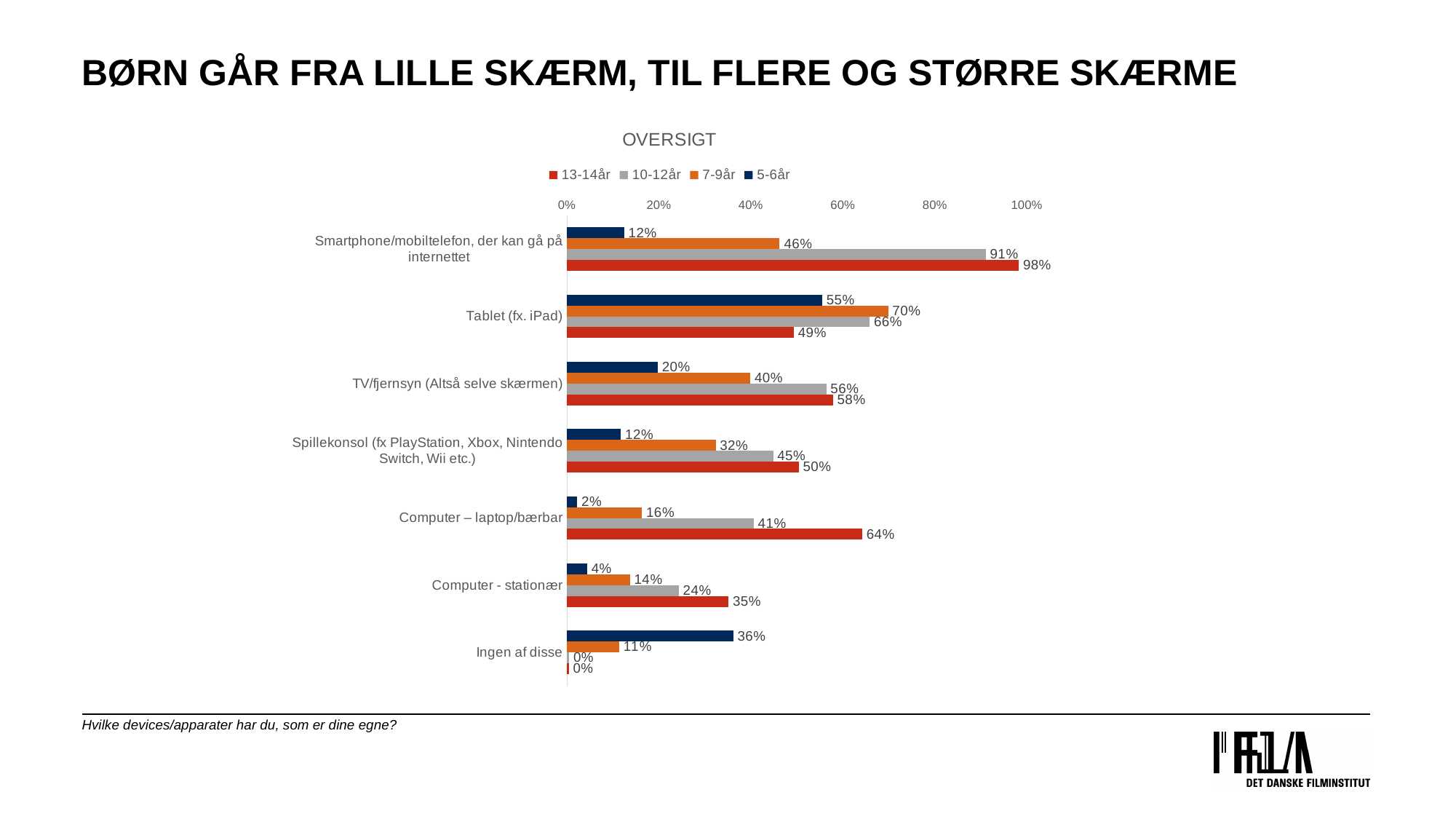
How many device categories are shown on the chart? 7 Which age group has the highest value for Ingen af disse? 5-6år Which is larger for Tablet (fx. iPad): the 7-9år value or the 13-14år value? 7-9år What kind of chart is shown on the slide? Bar chart What is the value for 5-6år for Tablet (fx. iPad)? 55% What is the difference between the 13-14år and 5-6år values for Computer – laptop/bærbar? 62% What is the value for 10-12år for Computer – laptop/bærbar? 41% What is the value for 13-14år for Smartphone/mobiltelefon, der kan gå på internettet? 98% What is the value for 7-9år for TV/fjernsyn (Altså selve skærmen)? 40% Which age group has the lowest value for Computer - stationær? 5-6år What is the title of the chart? OVERSIGT How many series does the legend list? 4